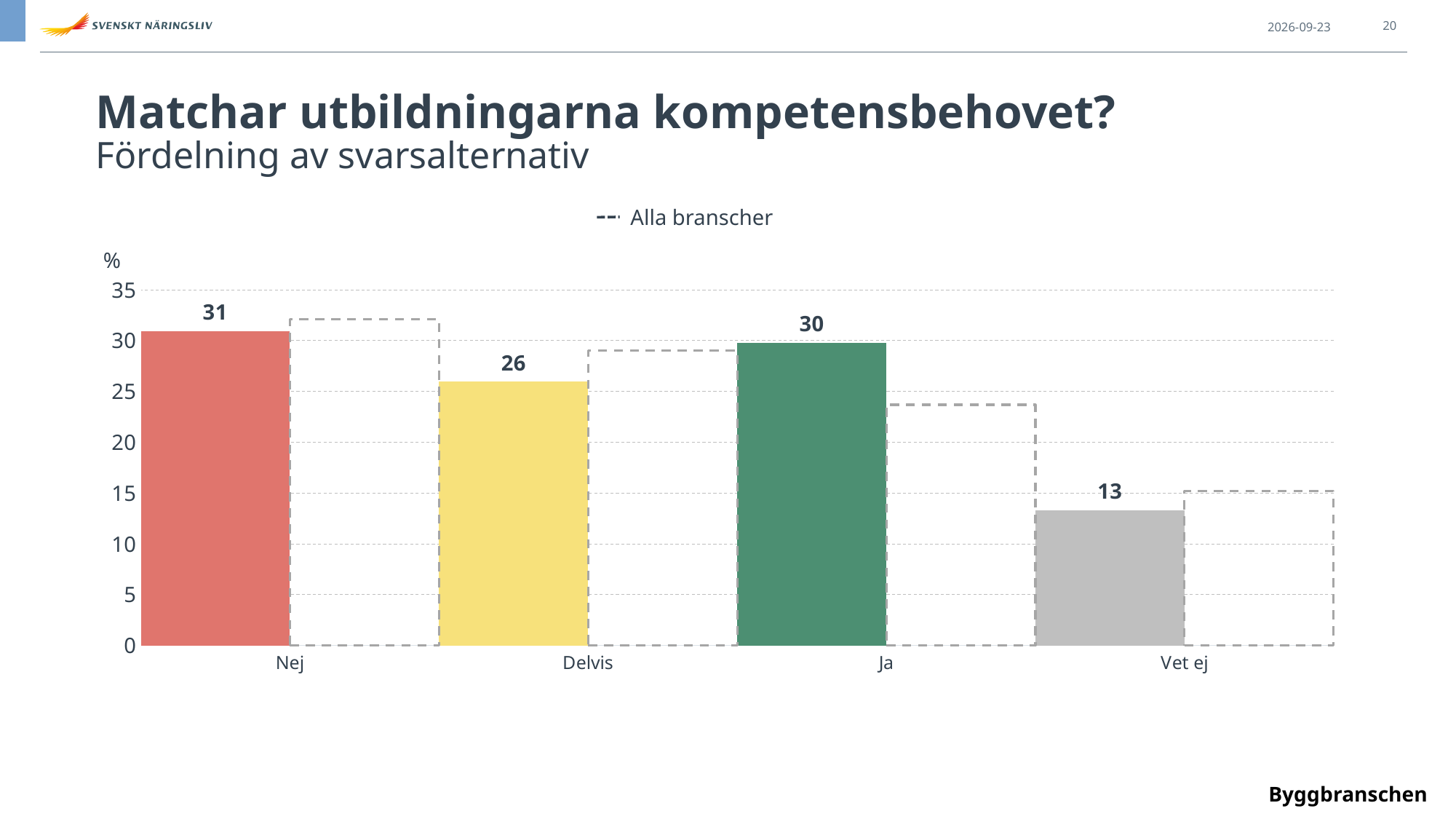
How many categories are shown on the x axis? 4 Which category has the highest labelled value? Nej What does the dashed outline in the legend represent? Alla branscher Which category has the lowest labelled value? Vet ej What is the value for Vet ej? 13 What is the difference between the values for Nej and Vet ej? 18 Is the dashed Alla branscher value for Ja greater or less than 25? less What is the value for Nej? 31 Is the dashed Alla branscher value for Delvis greater or less than 25? greater What is the value for Delvis? 26 What kind of chart is shown on the slide? Bar chart Which is larger, the value for Delvis or the value for Ja? Ja